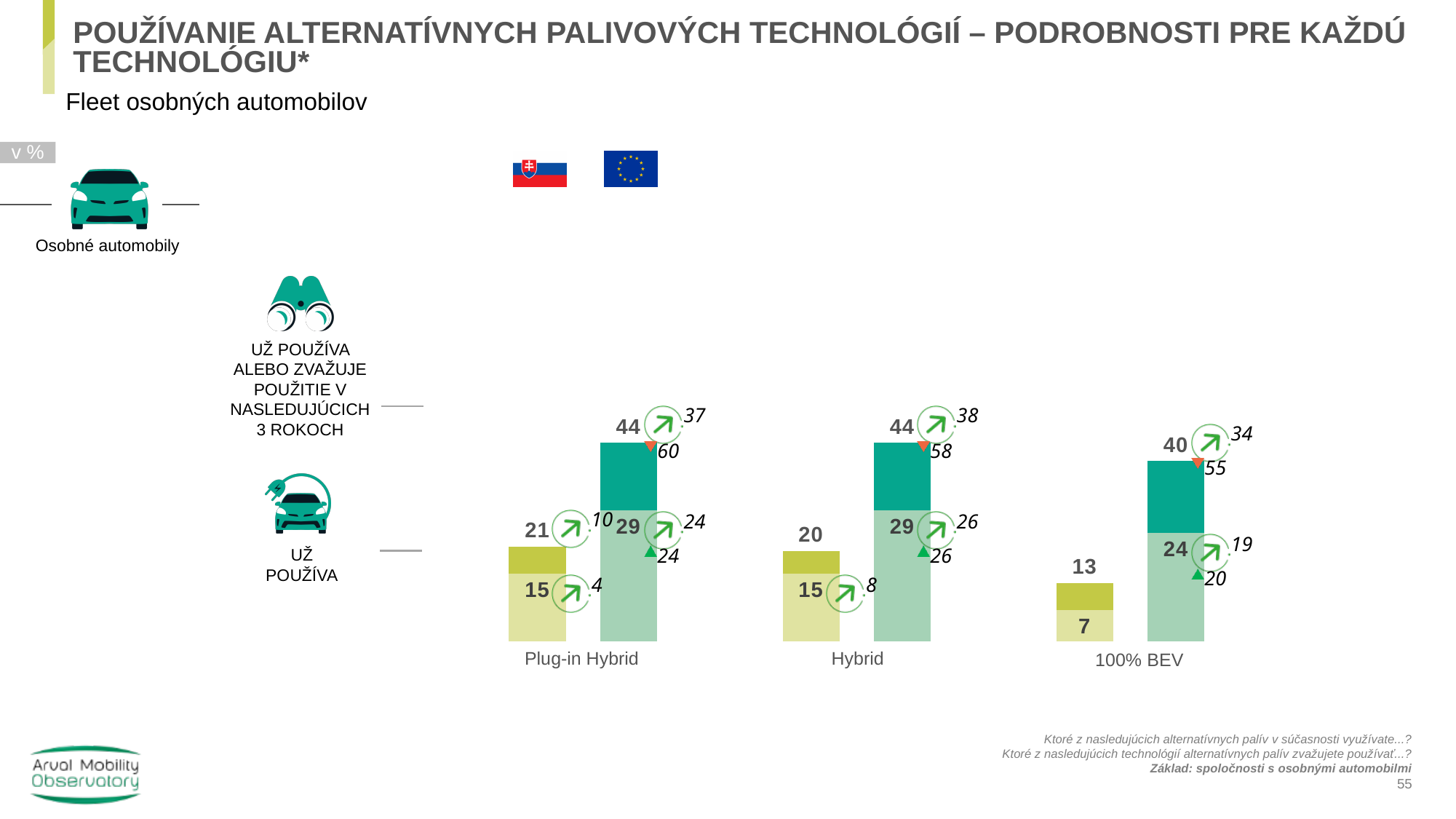
What is the top value labelled on the EU bar for 100% BEV? 40 For Plug-in Hybrid, which is larger: the top value of the Slovak bar or the top value of the EU bar? EU bar How many fuel technology categories are shown along the x axis? 3 What kind of chart is shown on the slide? bar chart What is the difference between the top value of the EU bar and the top value of the Slovak bar for Hybrid? 24 Which two flags are shown above the chart to identify the bar series? Slovakia and the EU Which category has the lowest top value on the EU bar? 100% BEV What is the top value labelled on the Slovak bar for Hybrid? 20 Which category has the lowest top value on the Slovak bar? 100% BEV What is the 'Už používa' value for the EU bar in the 100% BEV category? 24 What is the 'Už používa' value for the Slovak bar in the Plug-in Hybrid category? 15 What is the difference between the top value of the EU bar and the top value of the Slovak bar for 100% BEV? 27